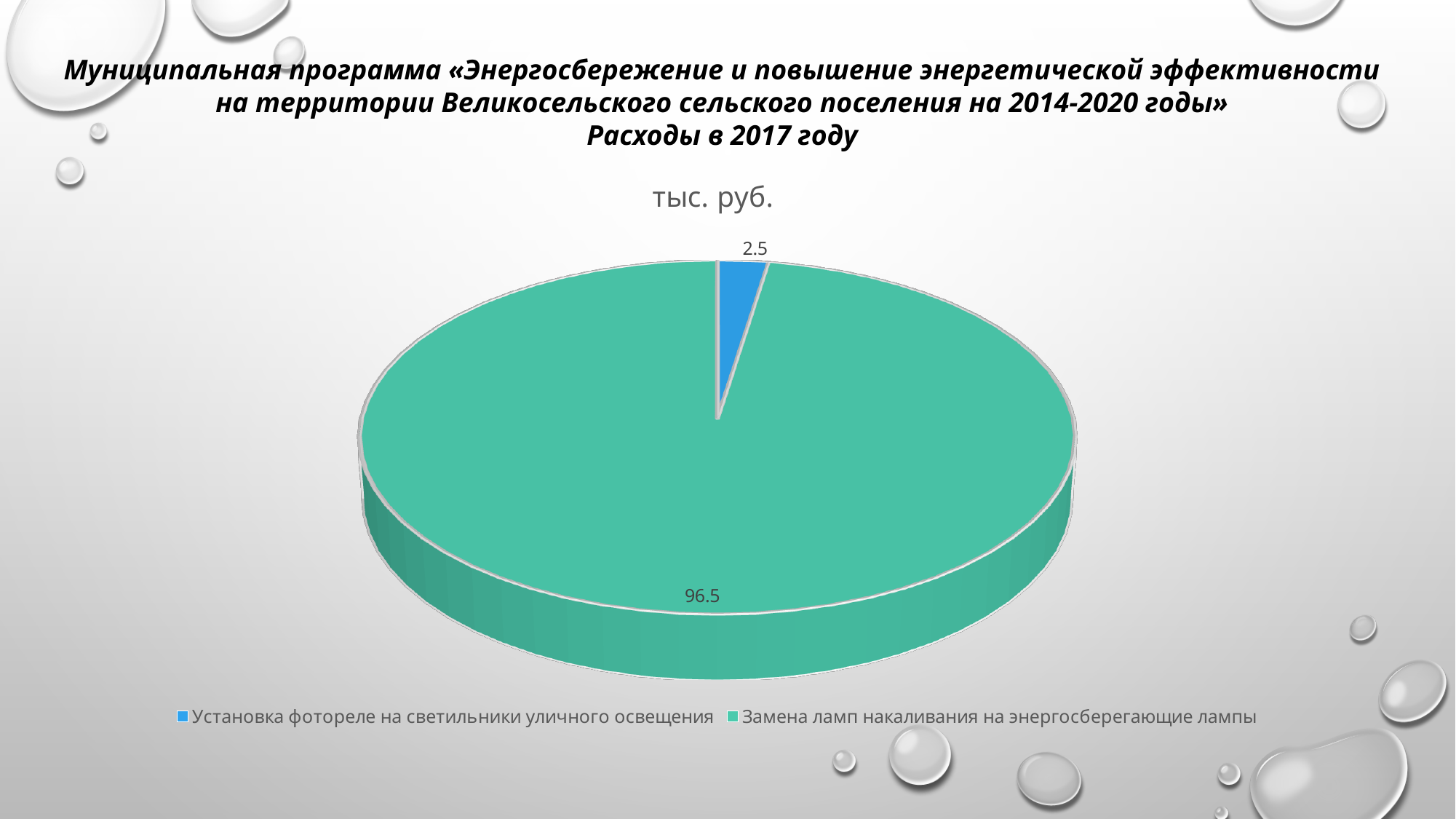
What colour is the slice for «Установка фотореле на светильники уличного освещения»? blue What is the value for «Замена ламп накаливания на энергосберегающие лампы»? 96.5 Which is larger: the value for «Установка фотореле на светильники уличного освещения» or for «Замена ламп накаливания на энергосберегающие лампы»? Замена ламп накаливания на энергосберегающие лампы What is the total of all slices in the pie chart? 99 What is the difference between the values for «Замена ламп накаливания на энергосберегающие лампы» and «Установка фотореле на светильники уличного освещения»? 94 What type of chart is shown on the slide? pie chart How many slices does the pie chart have? 2 Which category has the smallest slice of the pie? Установка фотореле на светильники уличного освещения Which category has the largest slice of the pie? Замена ламп накаливания на энергосберегающие лампы How many entries does the legend list? 2 What is the title of the chart? тыс. руб. What is the value for «Установка фотореле на светильники уличного освещения»? 2.5